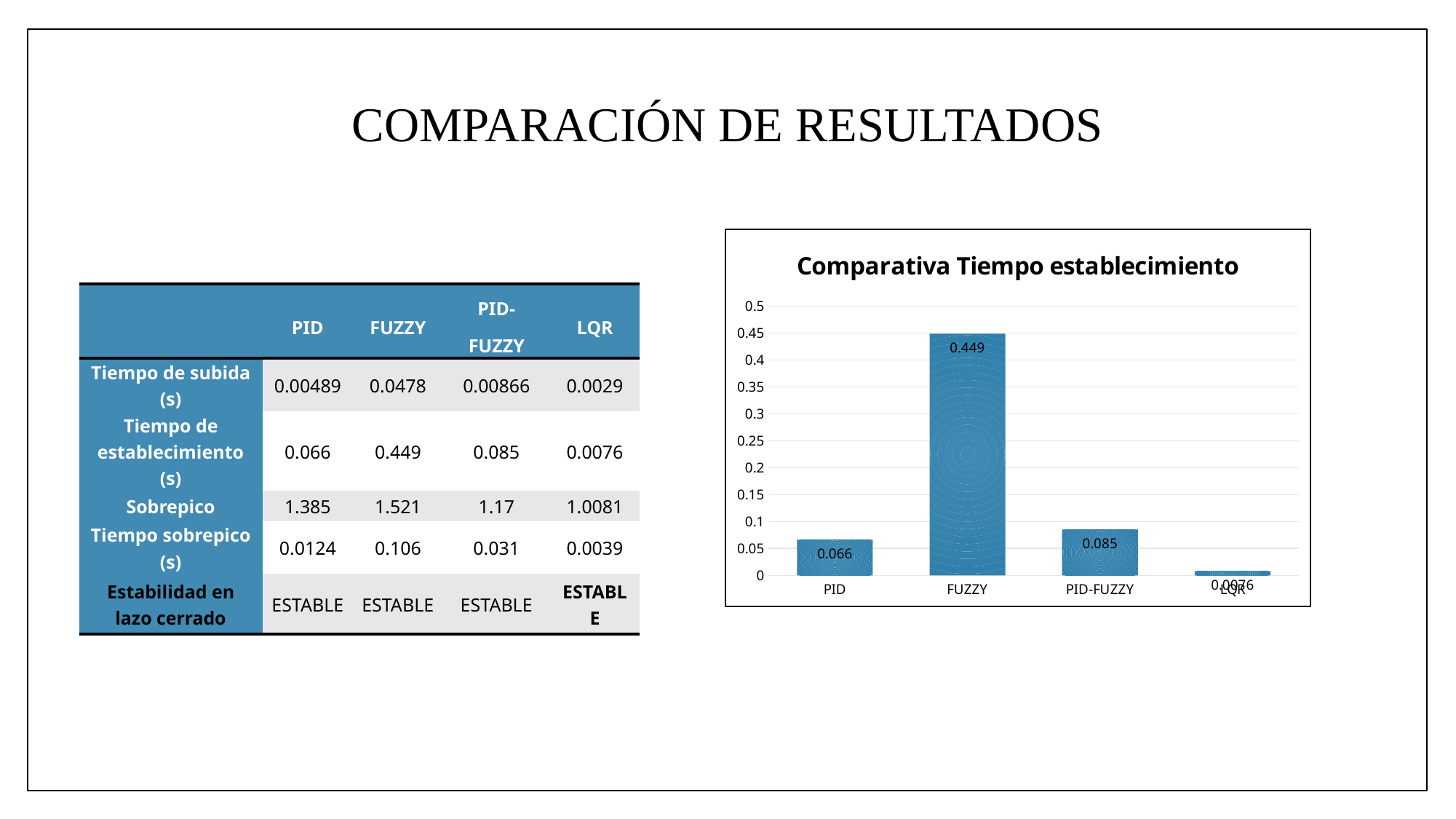
What is the value for FUZZY in the chart? 0.449 Which category has the lowest value in the chart? LQR Is the value for FUZZY greater or less than 0.4? greater What is the difference between the FUZZY and PID values in the chart? 0.383 What is the value for PID-FUZZY in the chart? 0.085 Which is larger in the chart, the value for PID or the value for PID-FUZZY? PID-FUZZY What kind of chart is shown on the slide? bar chart How many categories are shown in the chart? 4 What is the title of the chart? Comparativa Tiempo establecimiento Which category has the highest value in the chart? FUZZY What is the value for PID in the chart? 0.066 What is the value for LQR in the chart? 0.0076